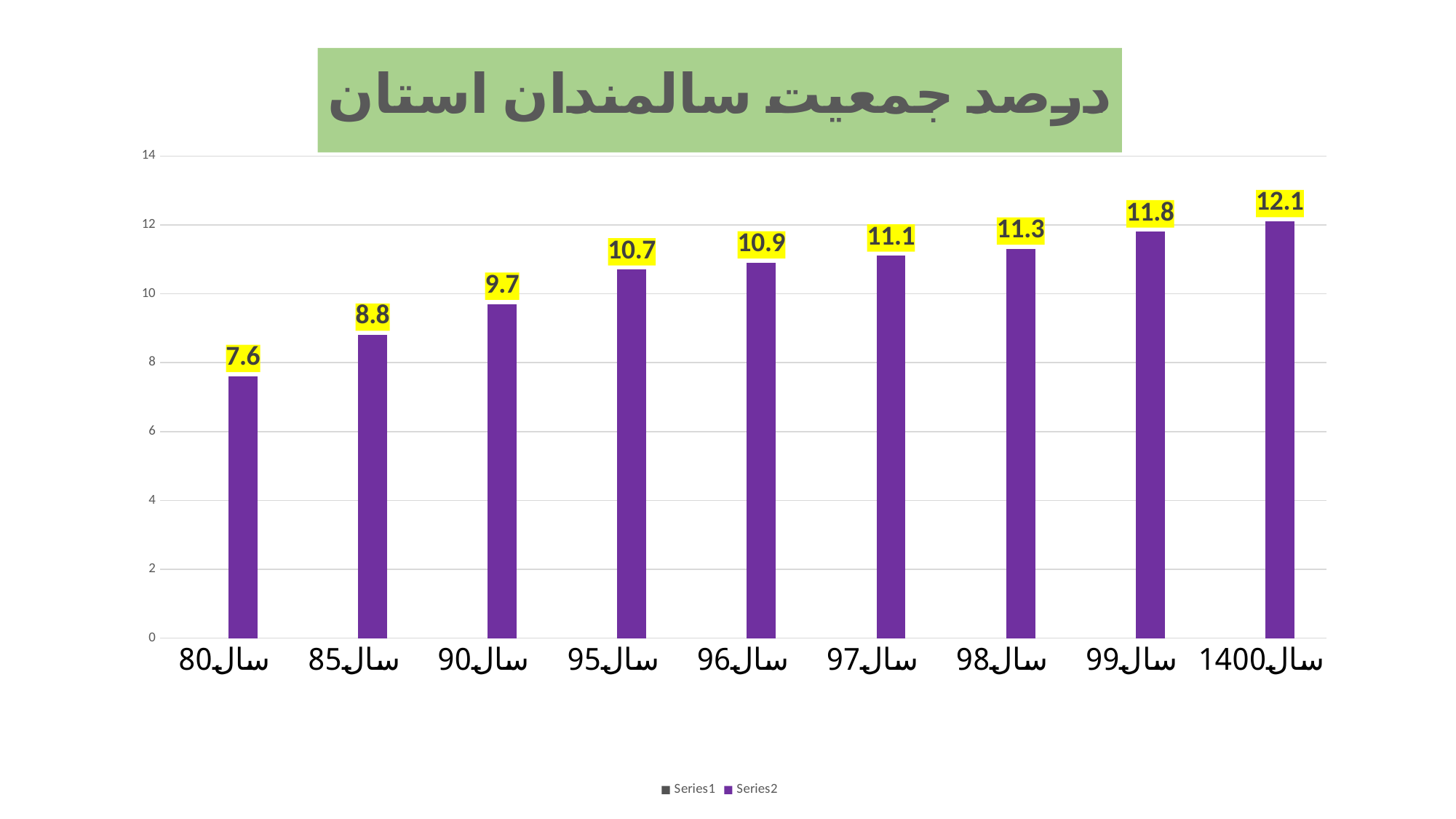
How many categories are shown on the x axis? 9 Is the value for سال98 greater or less than 10? greater What is the value for سال1400? 12.1 What is the value for سال95? 10.7 What is the difference between the values for سال1400 and سال80? 4.5 Which category has the highest value? سال1400 Do the values rise or fall from سال80 to سال1400? rise How many series does the legend list? 2 What is the value for سال80? 7.6 Which category has the lowest value? سال80 What kind of chart is shown? bar chart Which is larger, the value for سال90 or the value for سال85? سال90